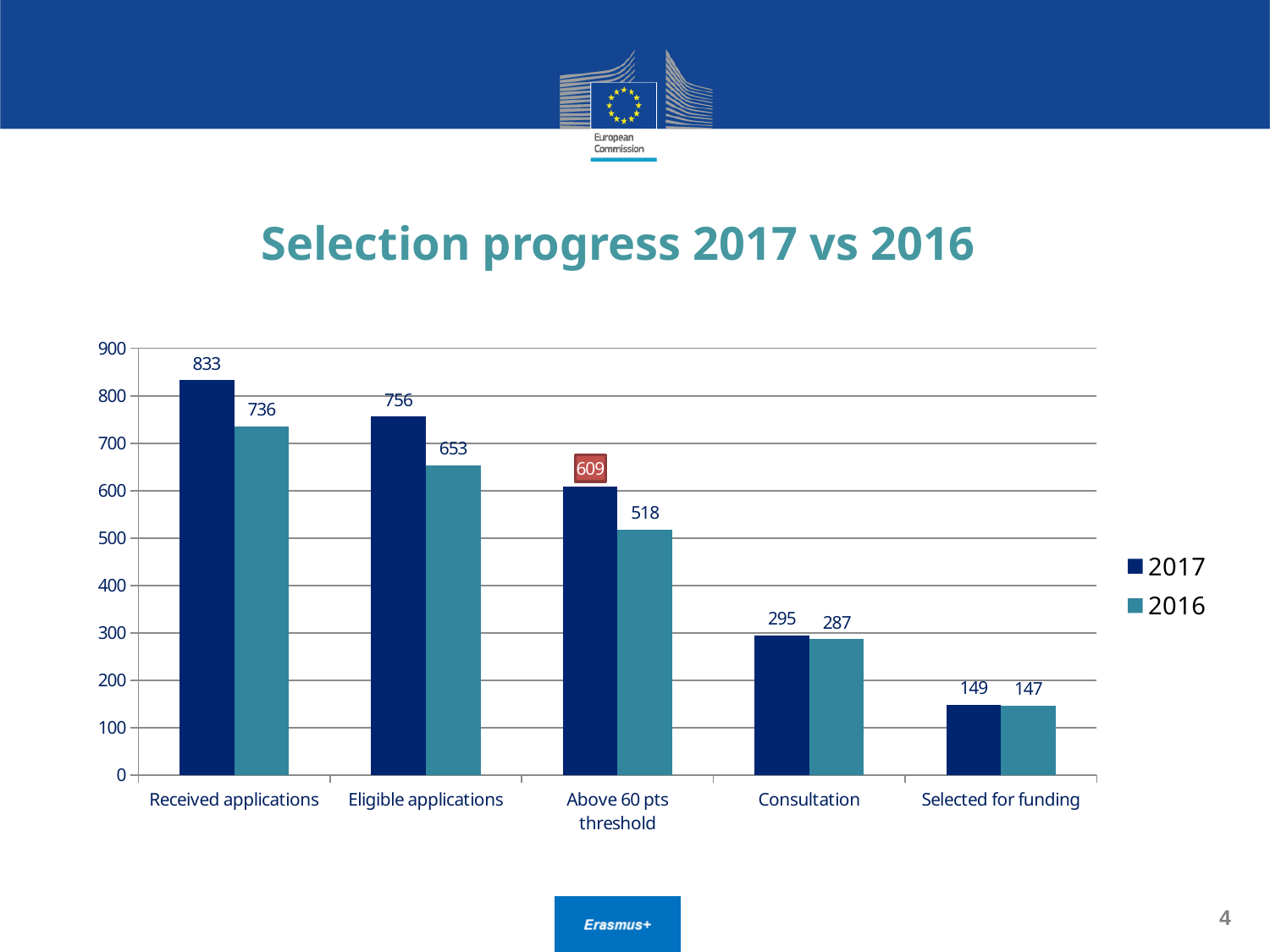
What kind of chart is shown on the slide? Bar chart Do the 2017 values rise or fall from left to right along the x axis? Fall What is the value for Above 60 pts threshold in 2016? 518 What is the value for Received applications in 2017? 833 How many categories are shown on the x axis? 5 How many series does the legend list? 2 What is the difference between the 2017 and 2016 values for Eligible applications? 103 Which is larger for Above 60 pts threshold, the 2017 value or the 2016 value? 2017 Which category has the lowest value for 2017? Selected for funding What is the value for Selected for funding in 2016? 147 What is the value for Consultation in 2017? 295 Which category has the highest value for 2016? Received applications